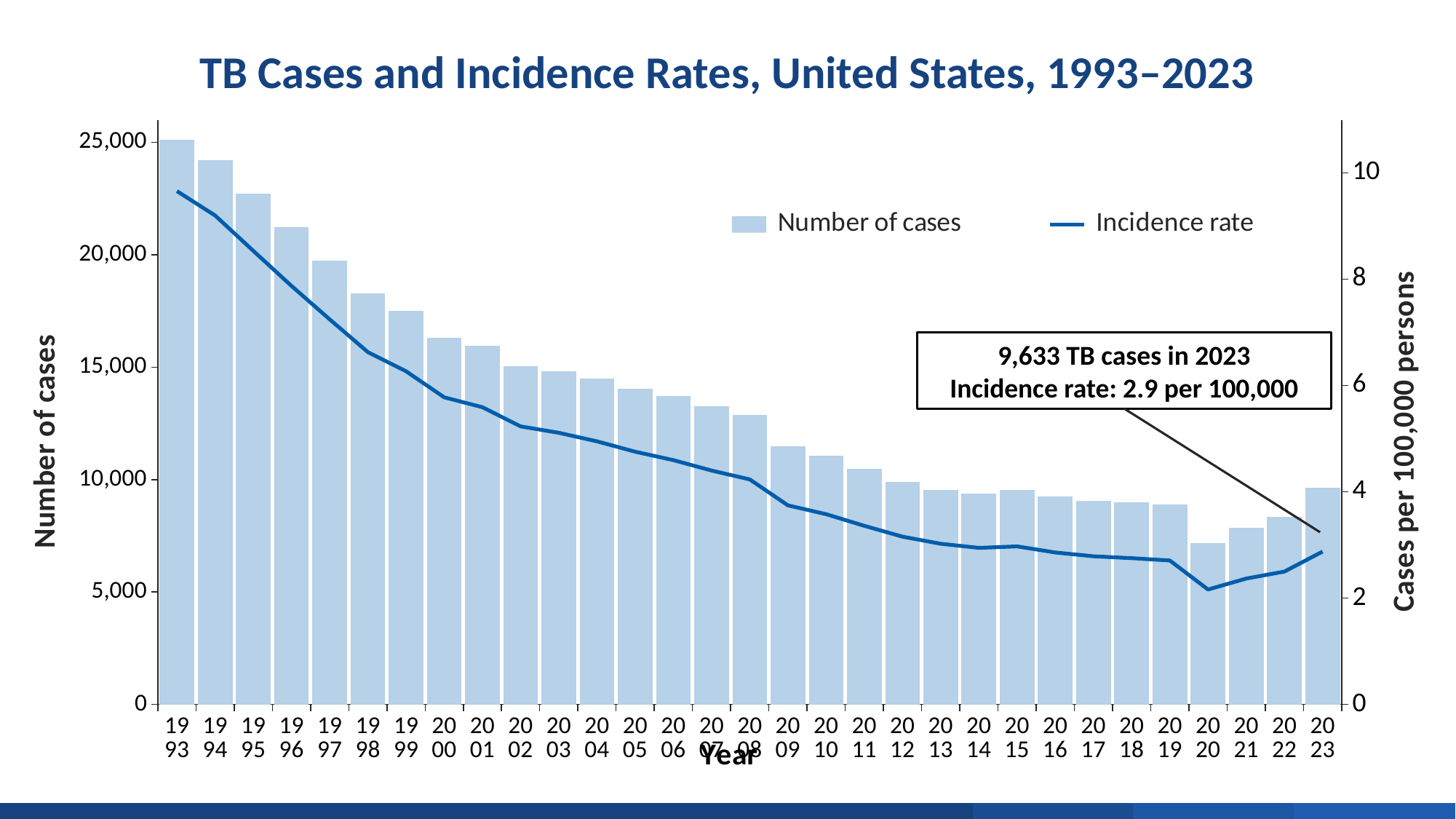
What was the TB incidence rate in 2023? 2.9 per 100,000 Is the number of cases in 2020 greater or less than 10,000? less Which year has the highest number of cases? 1993 Which year has the lowest incidence rate? 2020 How many years are shown on the x axis? 31 Which year has the lowest number of cases? 2020 Is the incidence rate in 1993 greater or less than 8 per 100,000? greater How many series does the legend list? 2 What is the title of the chart? TB Cases and Incidence Rates, United States, 1993–2023 What are the two series named in the legend? Number of cases; Incidence rate Does the number of cases rise or fall from 1993 to 2019? fall How many TB cases were reported in 2023? 9,633